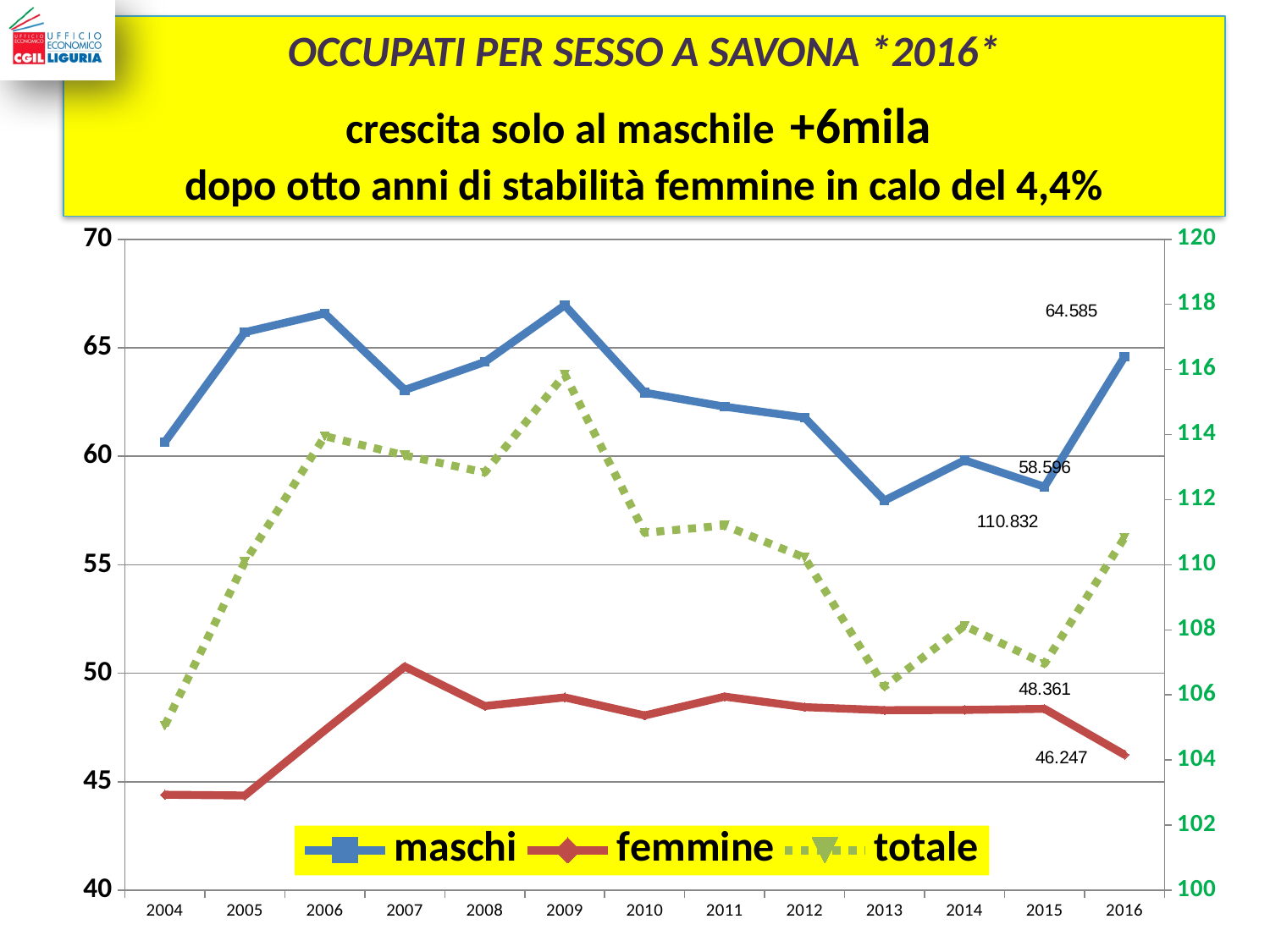
In which year is the femmine series at its highest? 2007 How many years are shown on the x axis? 13 What is the difference between the femmine values in 2015 and 2016? 2.114 Is the value for maschi in 2004 greater or less than 65? less What is the value for femmine in 2016? 46.247 How many series does the legend list? 3 What is the value for maschi in 2016? 64.585 What is the value for maschi in 2015? 58.596 In which year is the totale series at its highest? 2009 What kind of chart is shown on the slide? line chart What is the difference between the maschi values in 2016 and 2015? 5.989